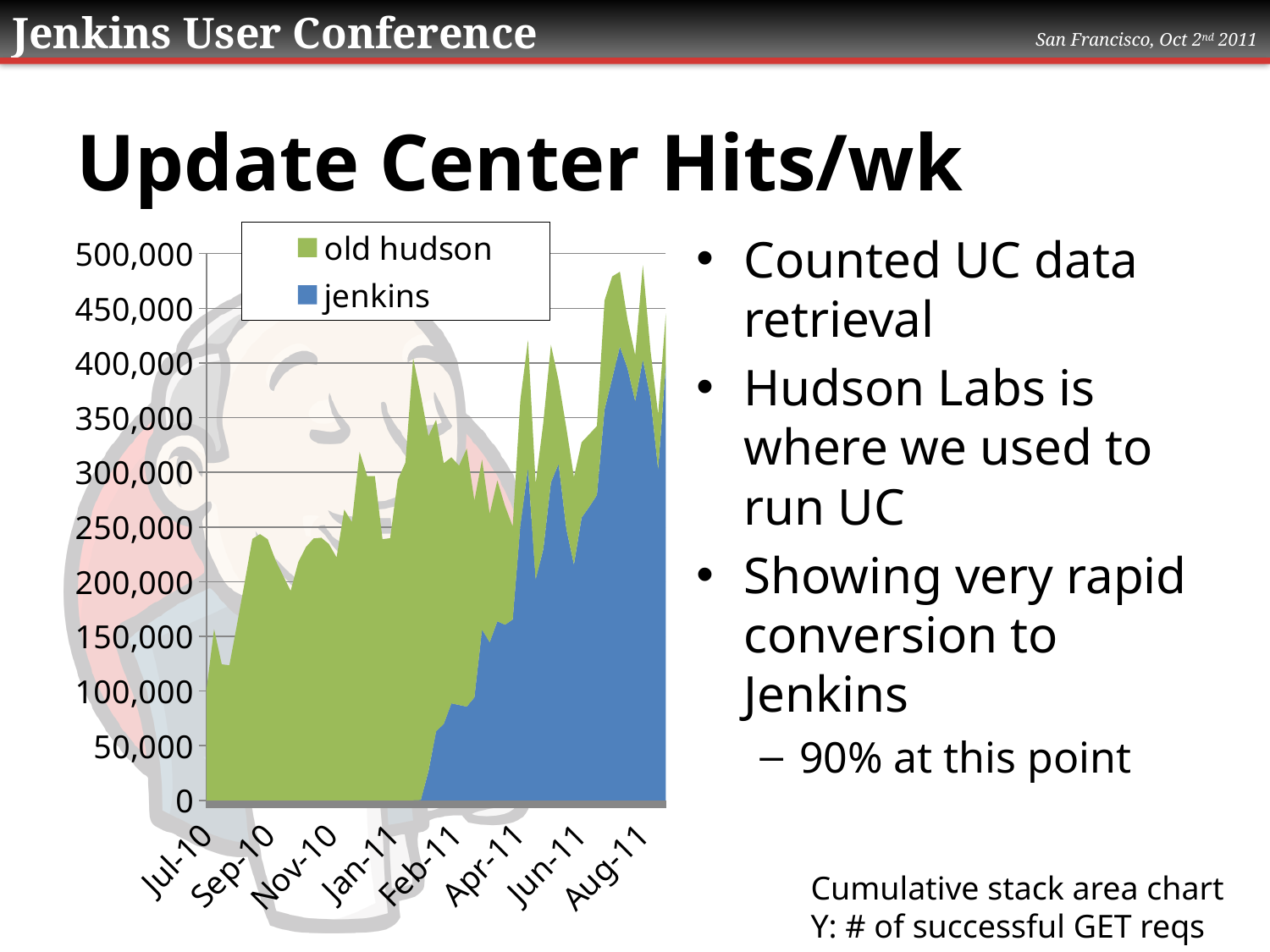
What kind of chart is shown on the slide? area chart How many series does the chart's legend list? 2 Is the jenkins value at Aug-11 greater or less than 250,000? greater Is the jenkins value at Jul-10 greater or less than 50,000? less What is the highest value shown on the chart's y axis? 500,000 Which series is shown in blue in the chart? jenkins What are the two series named in the chart's legend? old hudson and jenkins How many month labels are shown along the x axis of the chart? 8 Is the old hudson value at Jul-10 greater or less than 200,000? less Does the jenkins series rise or fall from Feb-11 to Aug-11? rises At Aug-11, which series has the larger value, old hudson or jenkins? jenkins